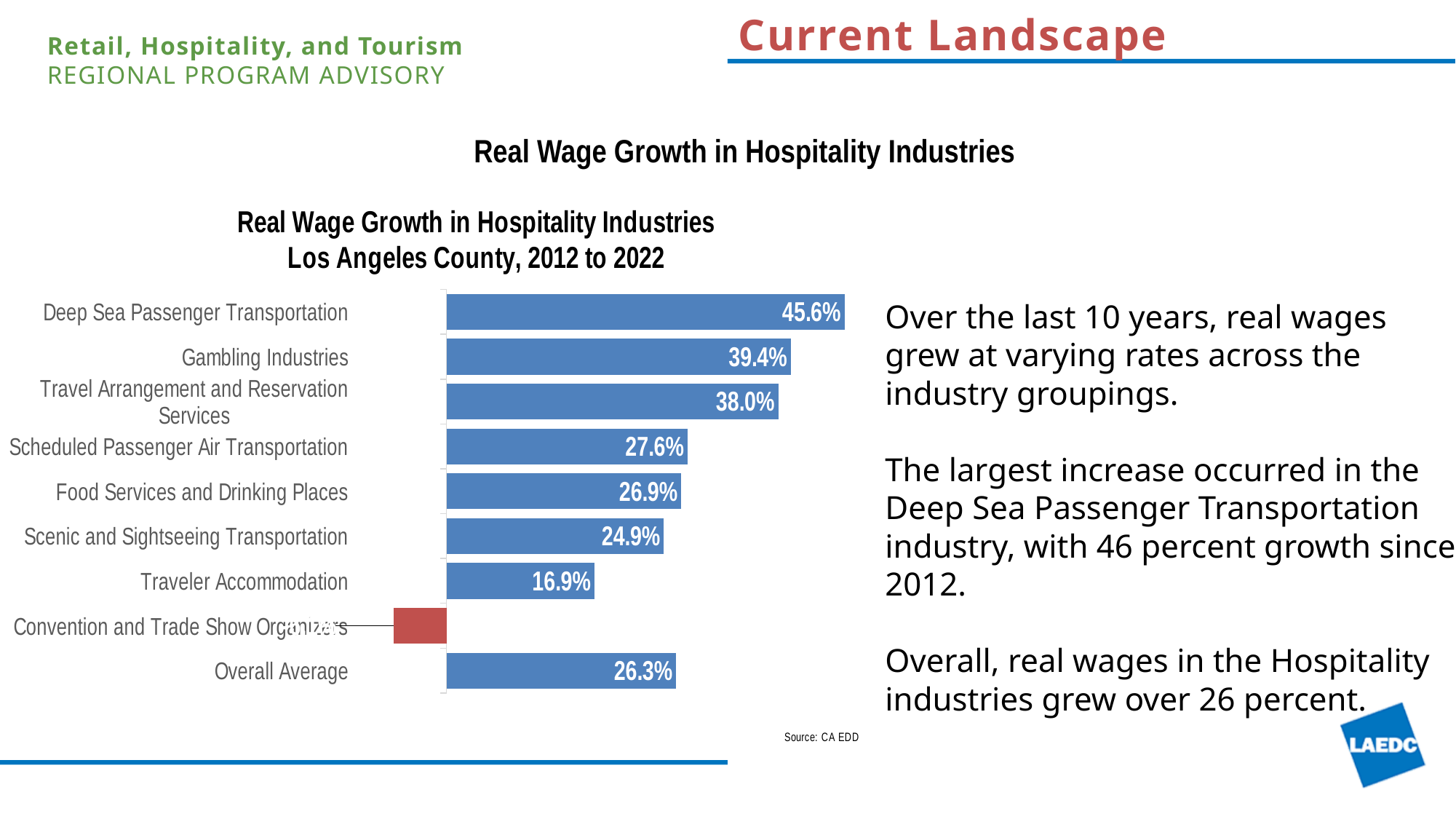
What is the Overall Average real wage growth shown on the chart? 26.3% Which industry has the lowest real wage growth on the chart? Convention and Trade Show Organizers What is the real wage growth value for Traveler Accommodation? 16.9% What is the real wage growth value for Scenic and Sightseeing Transportation? 24.9% What is the real wage growth value for Gambling Industries? 39.4% What is the difference in real wage growth between Deep Sea Passenger Transportation and Gambling Industries? 6.2 percentage points What is the real wage growth value for Deep Sea Passenger Transportation? 45.6% Which industry has the highest real wage growth on the chart? Deep Sea Passenger Transportation Which has higher real wage growth: Scheduled Passenger Air Transportation or Food Services and Drinking Places? Scheduled Passenger Air Transportation What type of chart is shown on the slide? Bar chart What is the source cited for the chart? CA EDD How many categories (bars) are shown on the chart? 9